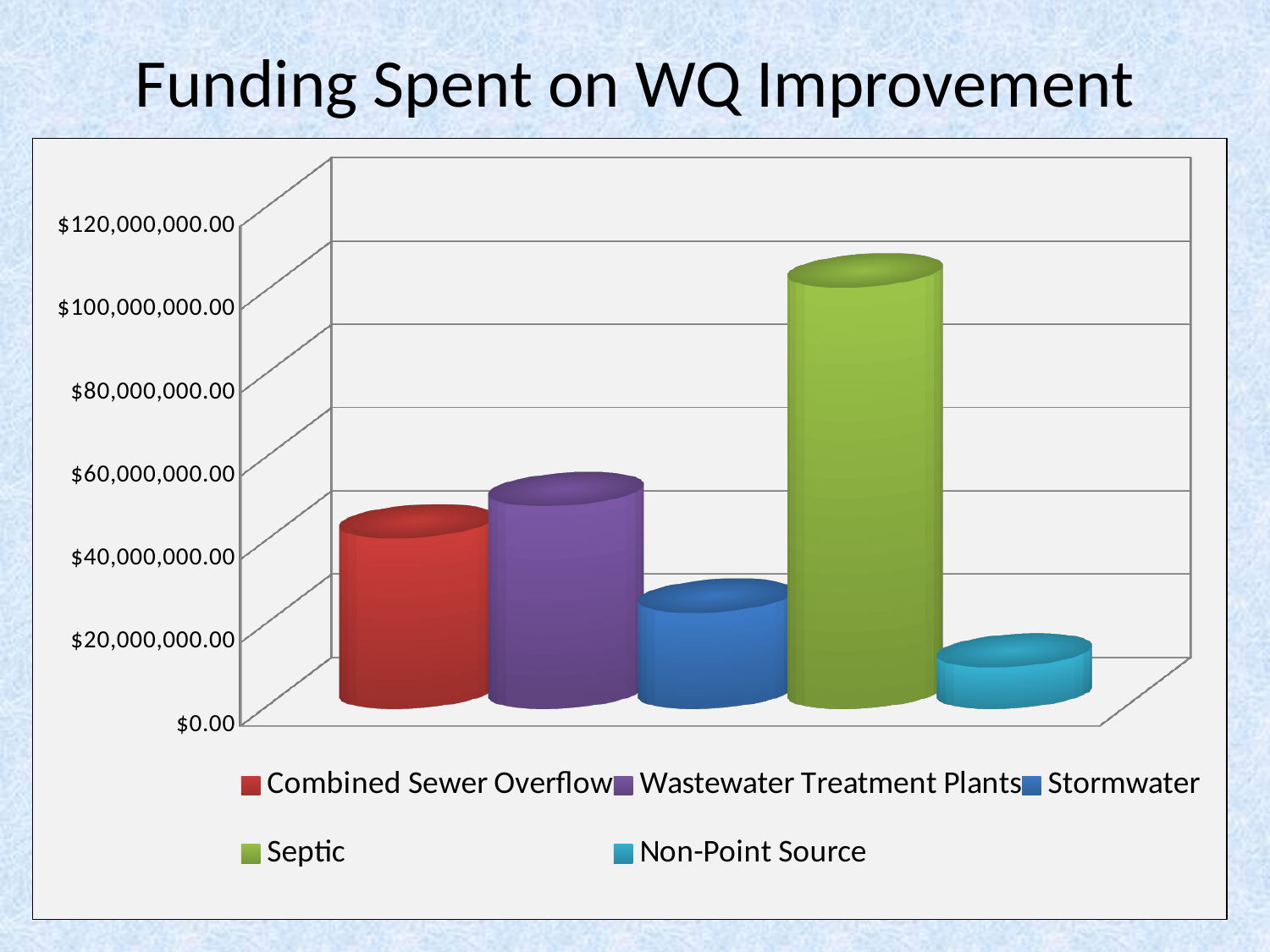
What is the title of the slide? Funding Spent on WQ Improvement Is the value for Septic greater or less than $80,000,000.00? greater Is the value for Combined Sewer Overflow greater or less than $20,000,000.00? greater Which has more funding spent, Septic or Stormwater? Septic How many categories are plotted in the chart? 5 Which category has the lowest funding spent? Non-Point Source Is the value for Non-Point Source greater or less than $20,000,000.00? less How many entries does the legend list? 5 Which category has the highest funding spent? Septic Which has more funding spent, Wastewater Treatment Plants or Combined Sewer Overflow? Wastewater Treatment Plants What kind of chart is shown on the slide? Bar chart